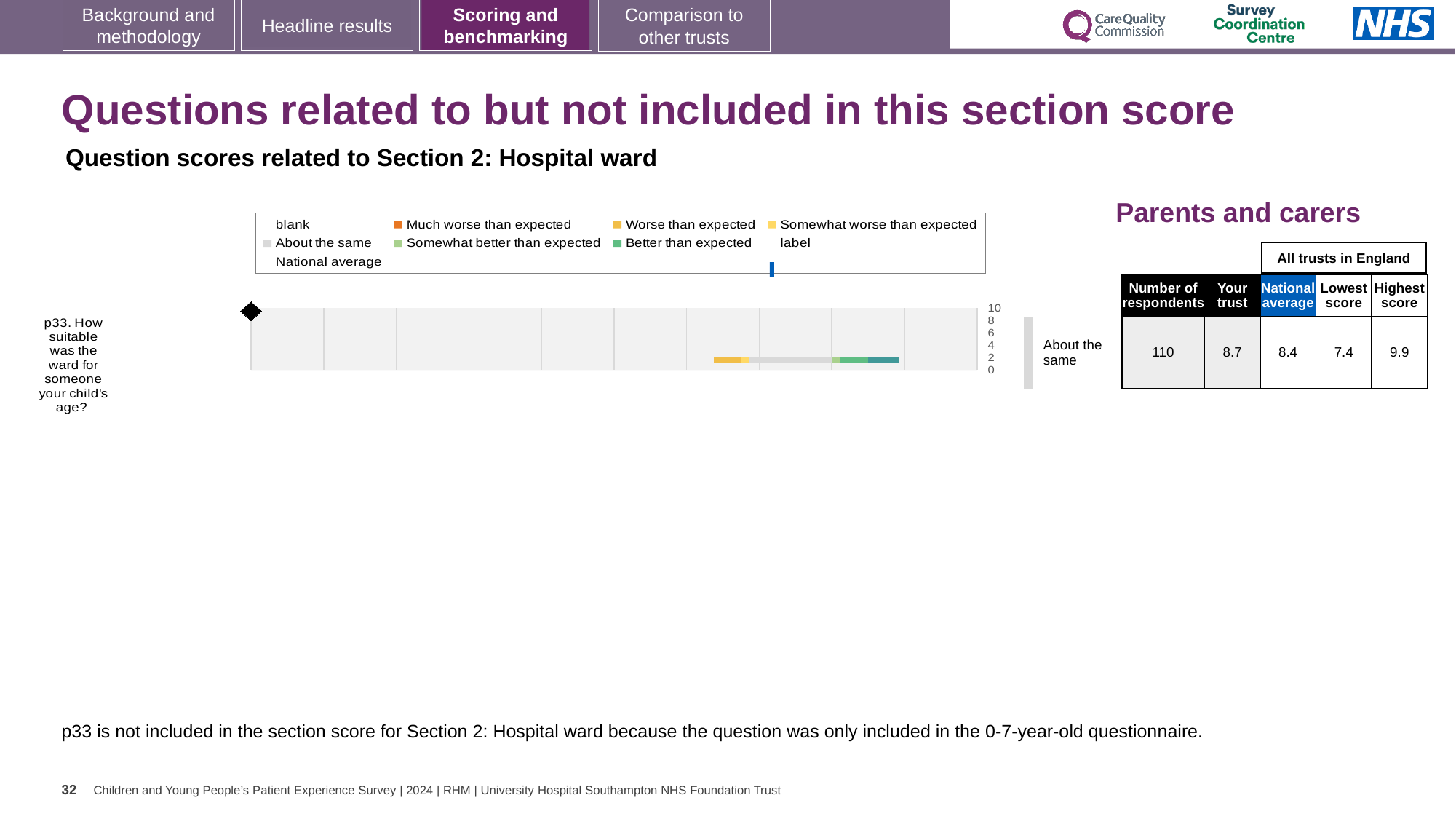
How many questions (categories) are plotted in the chart? 1 In the table next to the chart, what is the Highest score among all trusts in England for p33? 9.9 What kind of chart is shown for question p33? bar chart Which question is plotted in the chart? p33. How suitable was the ward for someone your child's age? In the table next to the chart, how many respondents answered p33? 110 In the table next to the chart, what is the Lowest score among all trusts in England for p33? 7.4 In the table next to the chart, what is the National average score for p33? 8.4 In the table next to the chart, what is the 'Your trust' score for p33? 8.7 What benchmark result label is shown to the right of the p33 bar? About the same Which is larger for p33, the 'Your trust' score or the National average? Your trust What is the difference between the Highest score and the Lowest score for p33 in the table? 2.5 What is the highest tick value shown on the chart's axis? 10